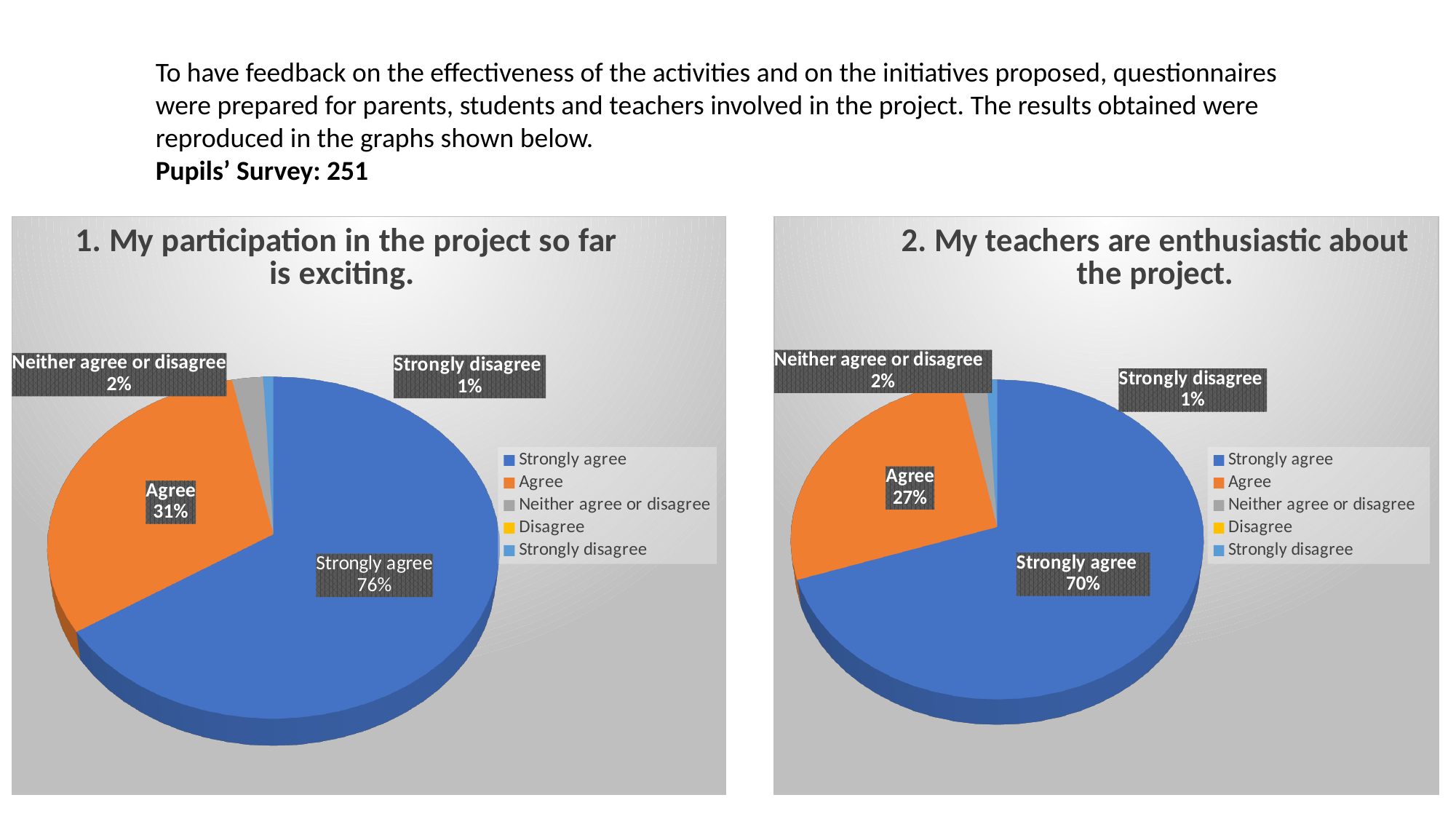
In the chart titled "2. My teachers are enthusiastic about the project.", what percentage is shown for Agree? 27% In the chart titled "1. My participation in the project so far is exciting.", what is the difference between the Strongly agree and Agree percentages? 45% In the chart titled "2. My teachers are enthusiastic about the project.", which labelled category has the smallest slice? Strongly disagree In the chart titled "1. My participation in the project so far is exciting.", which category has the largest slice? Strongly agree In the chart titled "1. My participation in the project so far is exciting.", what percentage is shown for Agree? 31% How many entries does the legend list in the chart titled "1. My participation in the project so far is exciting."? 5 In the chart titled "2. My teachers are enthusiastic about the project.", what percentage is shown for Strongly agree? 70% In the chart titled "1. My participation in the project so far is exciting.", what percentage is shown for Strongly agree? 76% Which chart shows a larger Strongly agree percentage, the left chart (question 1) or the right chart (question 2)? The left chart (question 1) What type of chart is used for "2. My teachers are enthusiastic about the project."? Pie chart In the chart titled "2. My teachers are enthusiastic about the project.", what percentage is shown for Neither agree or disagree? 2% In the chart titled "2. My teachers are enthusiastic about the project.", what is the difference between the Strongly agree and Agree percentages? 43%